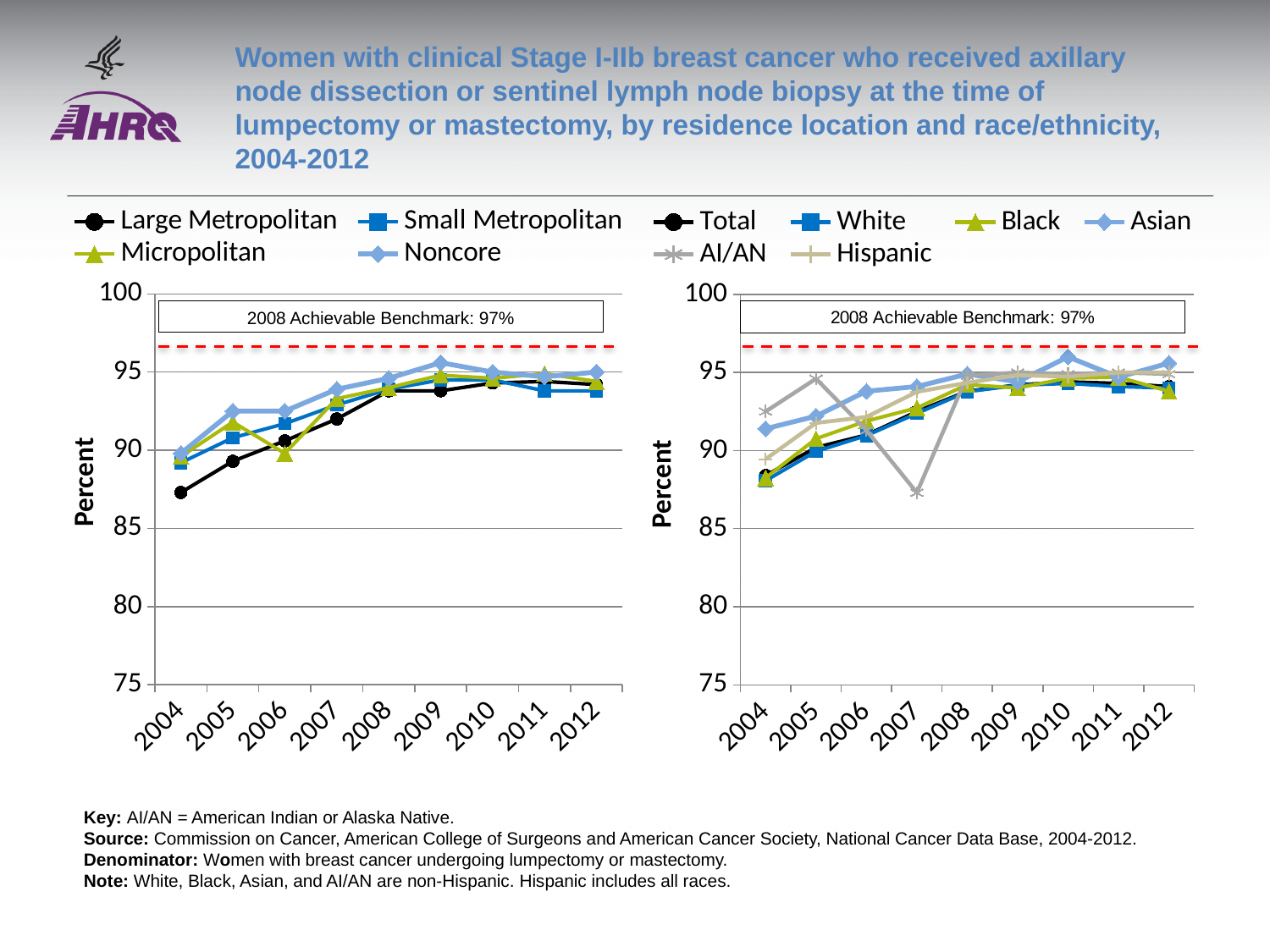
How many series does the legend of the right chart (by race/ethnicity) list? 6 In the right chart (by race/ethnicity), which is larger in 2004, Asian or Total? Asian In the left chart (by residence location), is the value for Noncore in 2009 greater or less than 95? greater In the left chart (by residence location), is the value for Large Metropolitan in 2004 greater or less than 90? less In the left chart (by residence location), does the Large Metropolitan line rise or fall from 2004 to 2012? rise How many years are shown on the x axis of the right chart (by race/ethnicity)? 9 What is the 2008 Achievable Benchmark shown on both charts? 97% In the right chart (by race/ethnicity), is the value for AI/AN in 2007 greater or less than 90? less How many series does the legend of the left chart (by residence location) list? 4 In the left chart (by residence location), which series has the lowest value in 2004? Large Metropolitan What kind of chart is the left chart (by residence location)? Line chart In the right chart (by race/ethnicity), which series has the lowest value in 2007? AI/AN